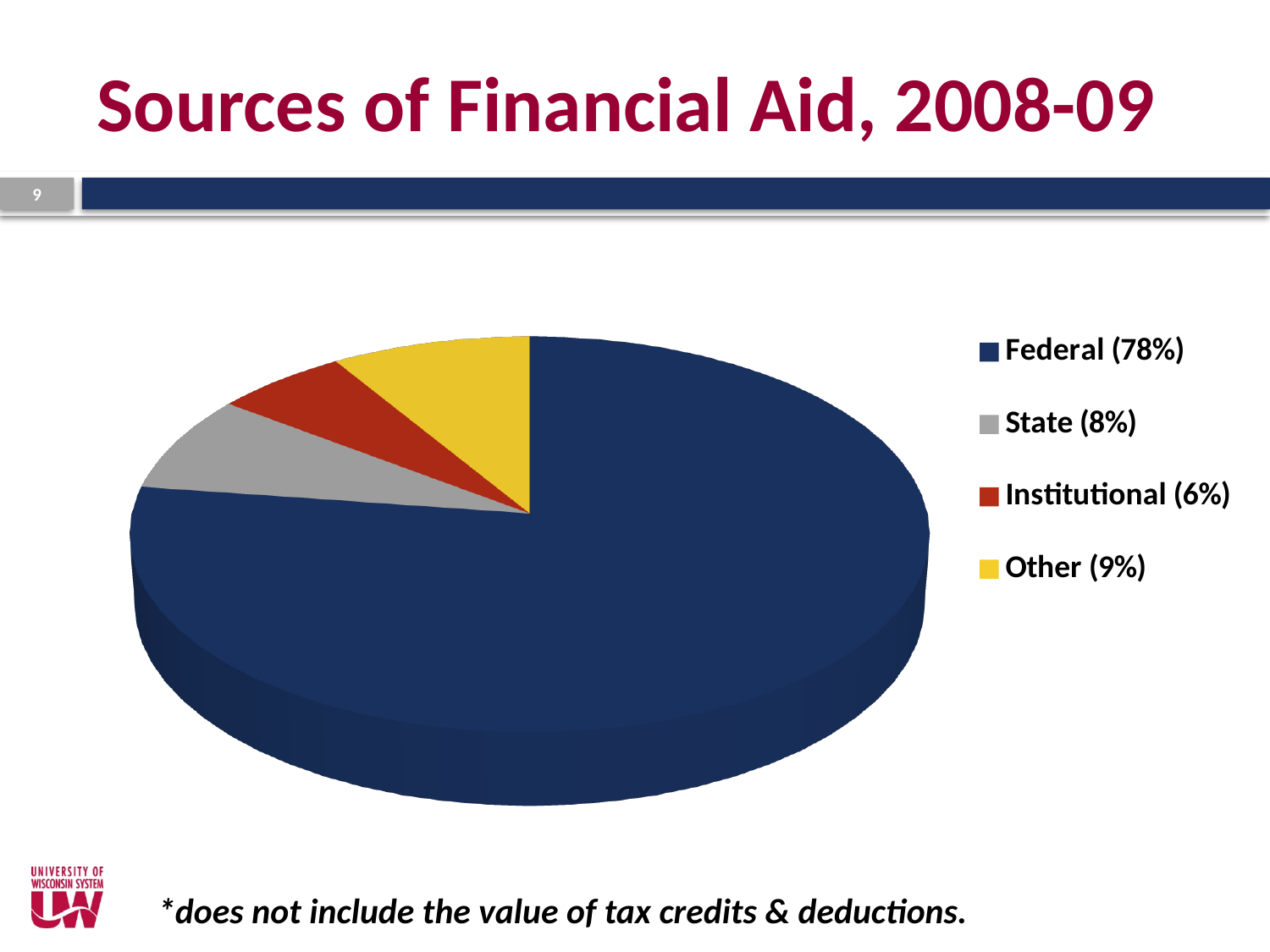
What share of financial aid comes from Other sources? 9% Which source of financial aid has the largest share? Federal What is the difference in percentage points between the Federal share and the State share? 70 Which colour represents the Other slice in the pie chart? Yellow What share of financial aid comes from Institutional sources? 6% What share of financial aid comes from Federal sources? 78% What kind of chart is shown on the slide? Pie chart How many sources of financial aid are shown in the pie chart? 4 What is the title of the chart on the slide? Sources of Financial Aid, 2008-09 Which is larger, the share for Other or the share for State? Other Which source of financial aid has the smallest share? Institutional